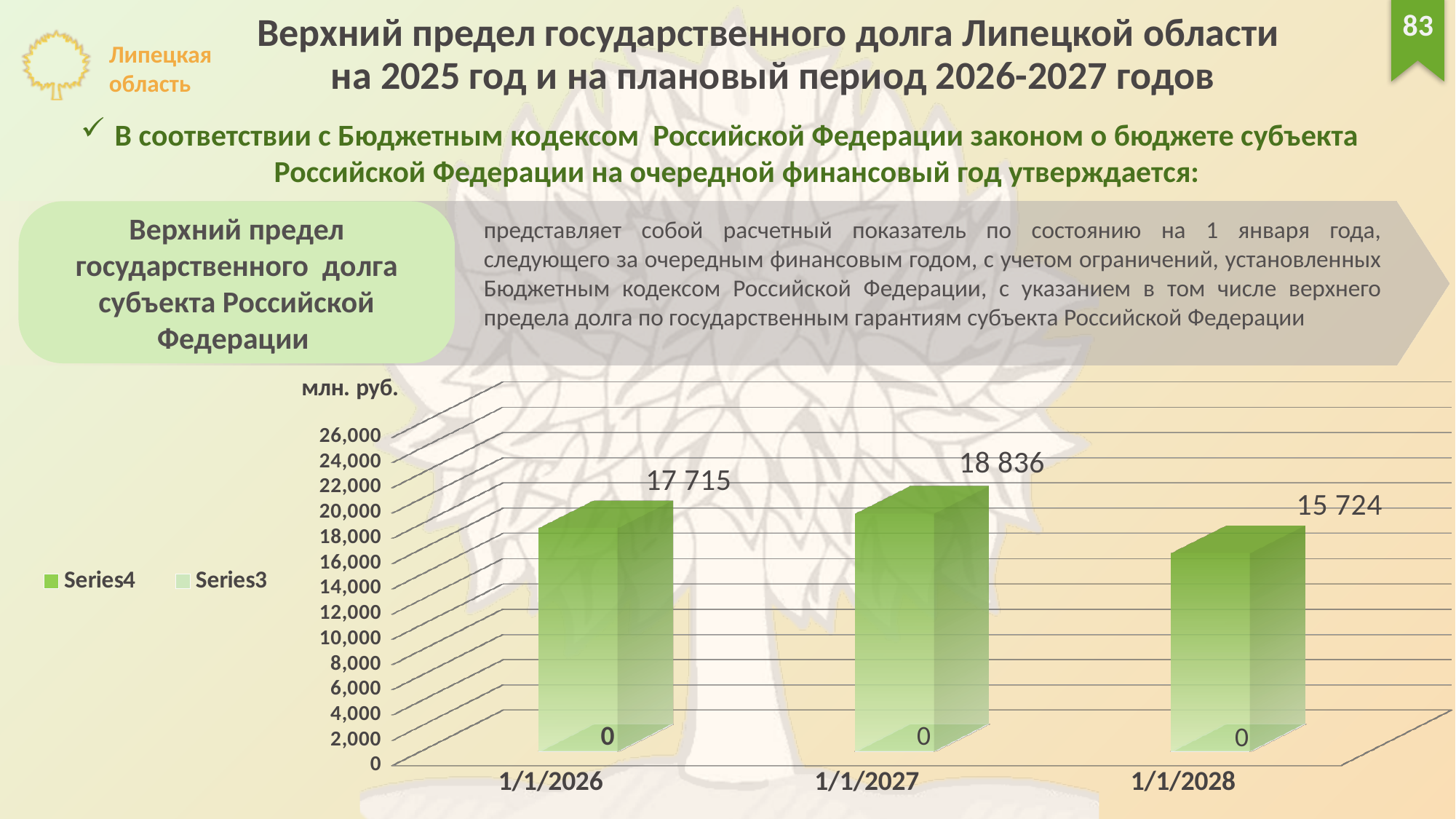
What kind of chart is shown on the slide? bar chart What is the difference between the values for 1/1/2027 and 1/1/2026? 1 121 What unit is shown above the vertical axis of the chart? млн. руб. How many dates are shown on the x axis of the chart? 3 Which is larger, the value for 1/1/2026 or the value for 1/1/2028? 1/1/2026 What is the value for 1/1/2028 in the chart? 15 724 What is the value for 1/1/2026 in the chart? 17 715 Which date has the highest value in the chart? 1/1/2027 Which date has the lowest value in the chart? 1/1/2028 How many series does the chart legend list? 2 What is the difference between the values for 1/1/2026 and 1/1/2028? 1 991 What is the value for 1/1/2027 in the chart? 18 836